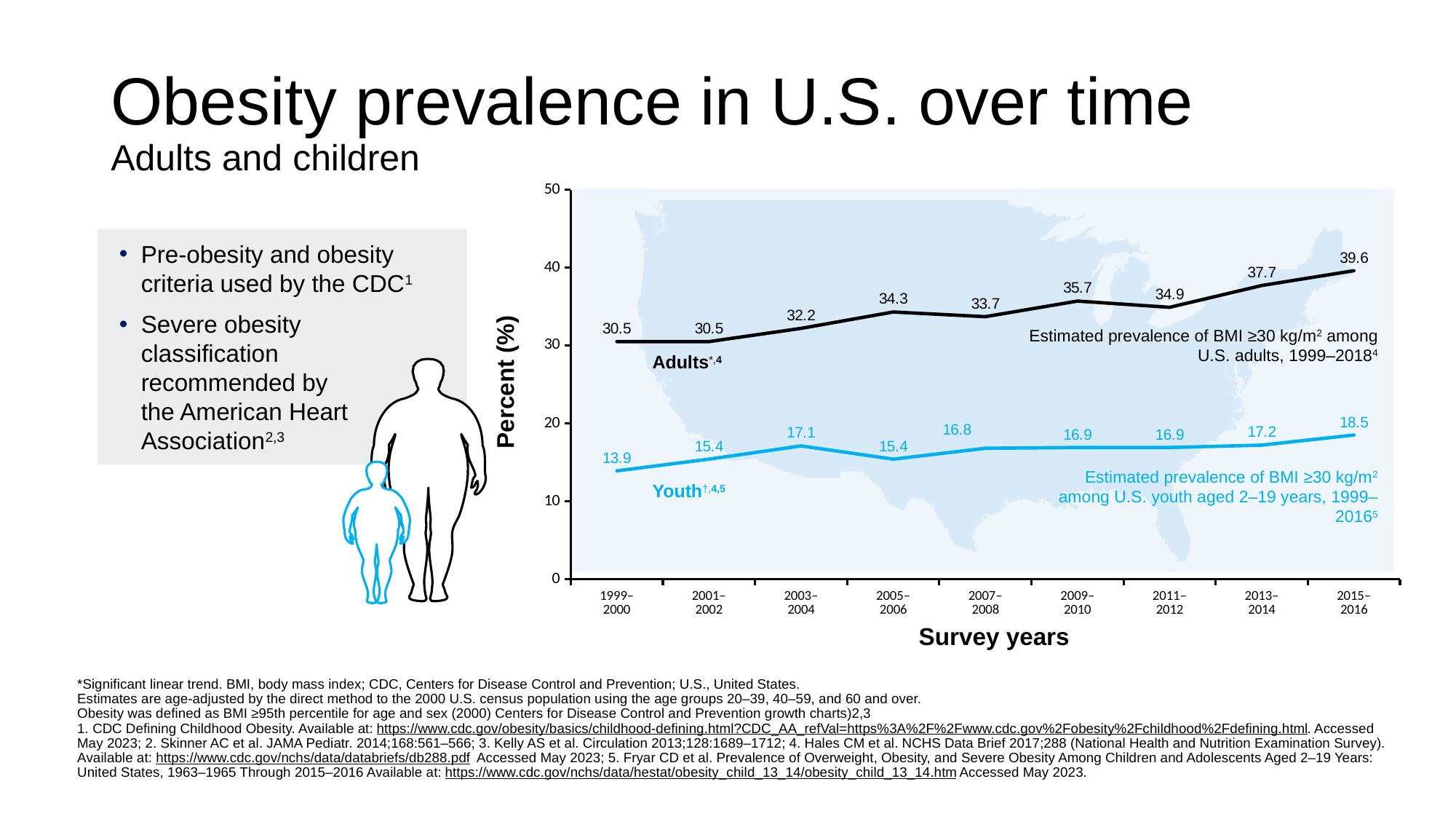
What is the obesity prevalence for Adults in the 2005–2006 survey years? 34.3 How many survey-year periods are shown on the x axis? 9 In which survey years is the Youth obesity prevalence lowest? 1999–2000 What is the obesity prevalence for Adults in the 2015–2016 survey years? 39.6 Which is larger, the Adults value in 2011–2012 or the Adults value in 2009–2010? 2009–2010 Does the Adults obesity prevalence generally rise or fall from 1999–2000 to 2015–2016? Rise What is the difference between the Adults and Youth obesity prevalence in 2015–2016? 21.1 What is the label of the y axis? Percent (%) How many data series are plotted on the chart? 2 What kind of chart is shown on the slide? Line chart What is the obesity prevalence for Youth in the 1999–2000 survey years? 13.9 In which survey years is the Adults obesity prevalence highest? 2015–2016